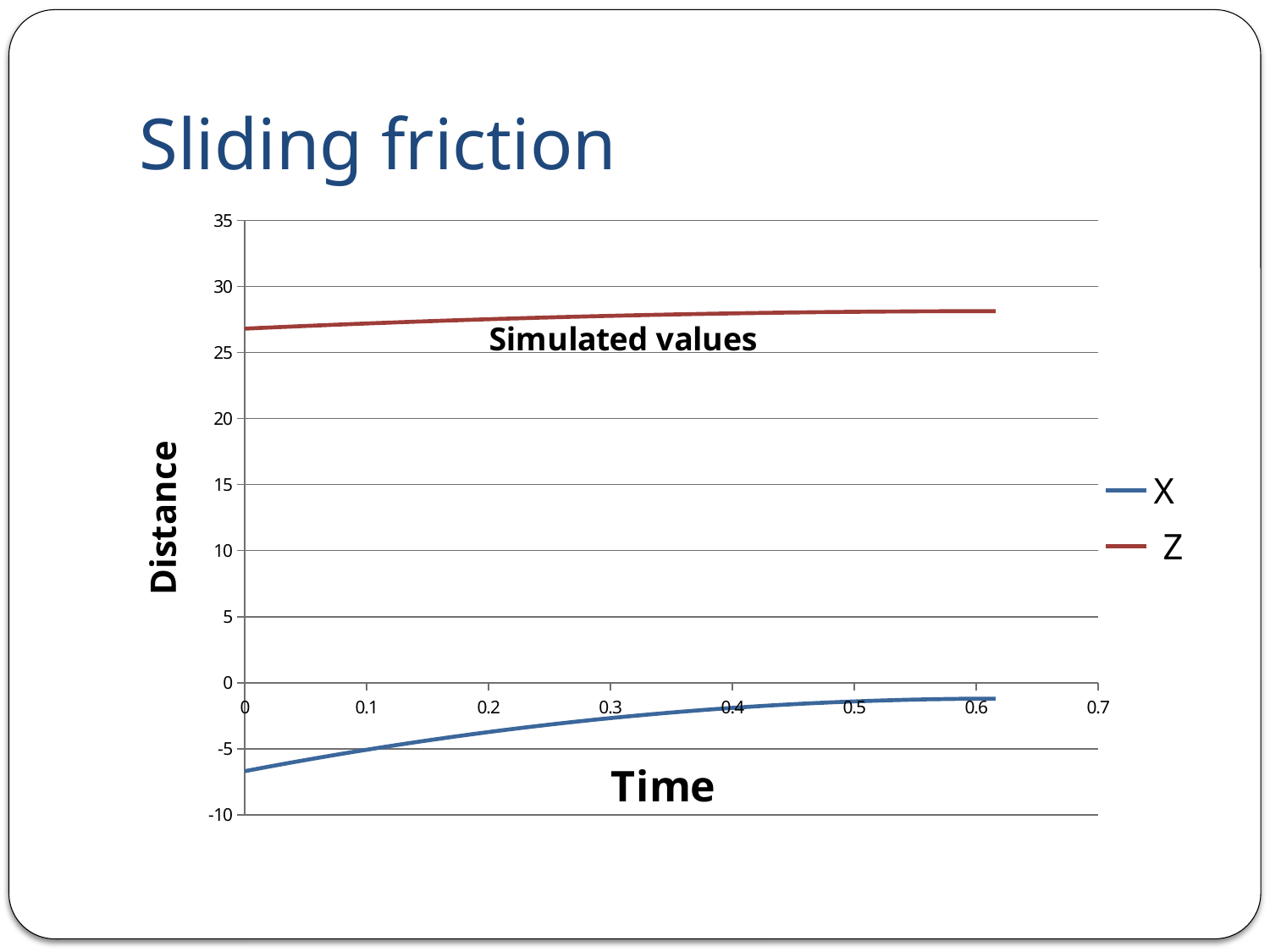
Does the Z series rise or fall as time increases? rise What kind of chart is shown on the slide? line chart Is the value of the X series at time 0.3 greater or less than -5? greater What text annotation appears on the chart near the Z line? Simulated values Does the X series rise or fall as time increases? rise How many series does the legend list? 2 Is the value of the Z series at time 0 greater or less than 25? greater Is the value of the X series at time 0.6 greater or less than 0? less What is the label of the vertical axis? Distance Which series is plotted higher on the chart, X or Z? Z